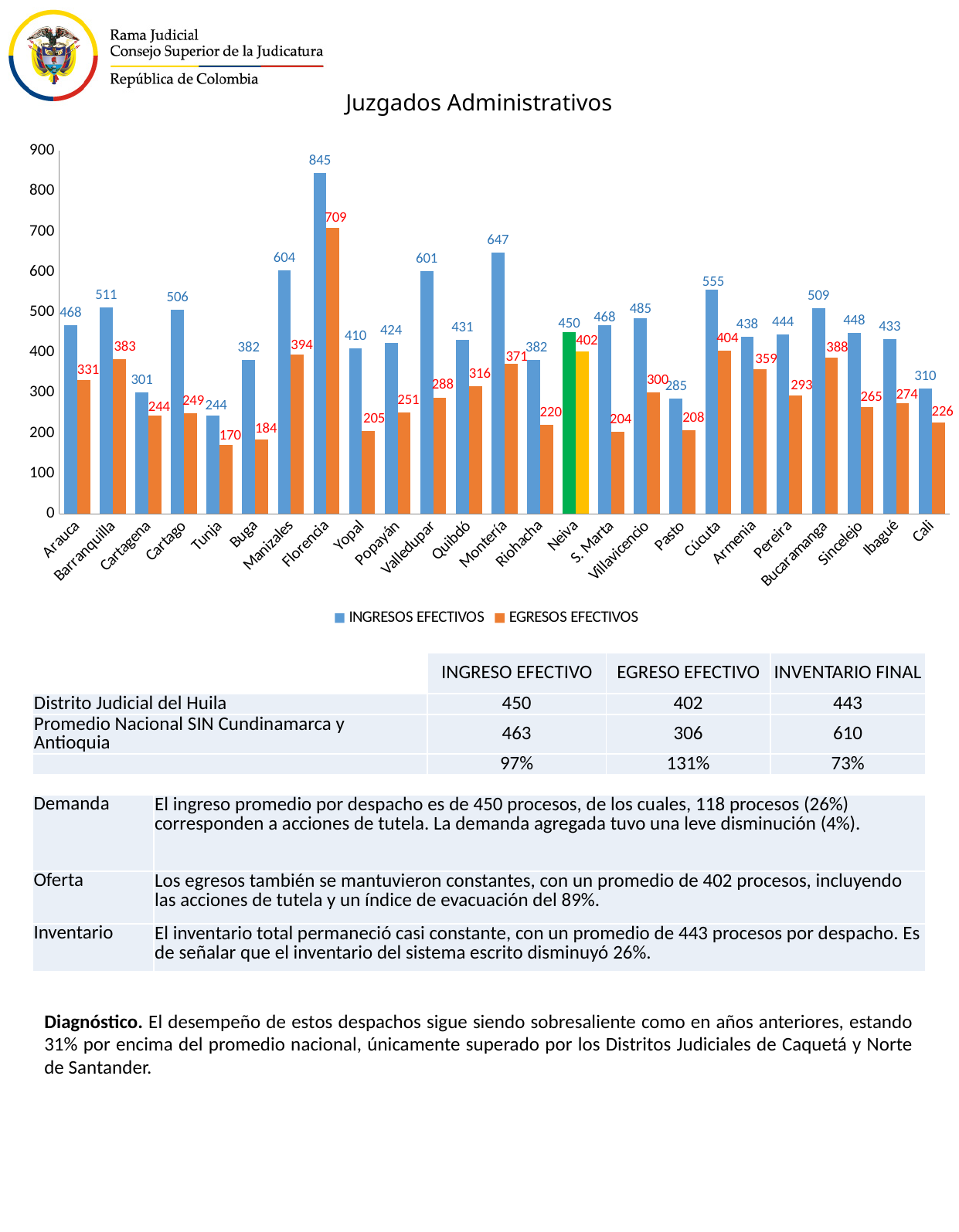
What is the EGRESOS EFECTIVOS value for Florencia? 709 What is the EGRESOS EFECTIVOS value for Cúcuta? 404 Is the INGRESOS EFECTIVOS value for Florencia greater or less than 800? greater Which city has the lowest EGRESOS EFECTIVOS value? Tunja How many series does the chart legend list? 2 What is the INGRESOS EFECTIVOS value for Neiva? 450 What kind of chart is shown on the slide? Bar chart Which city has the highest INGRESOS EFECTIVOS value? Florencia Which is larger, the INGRESOS EFECTIVOS value for Montería or for Manizales? Montería How many cities are shown on the x axis of the chart? 25 What is the difference between INGRESOS EFECTIVOS and EGRESOS EFECTIVOS for Neiva? 48 What is the title of the chart? Juzgados Administrativos